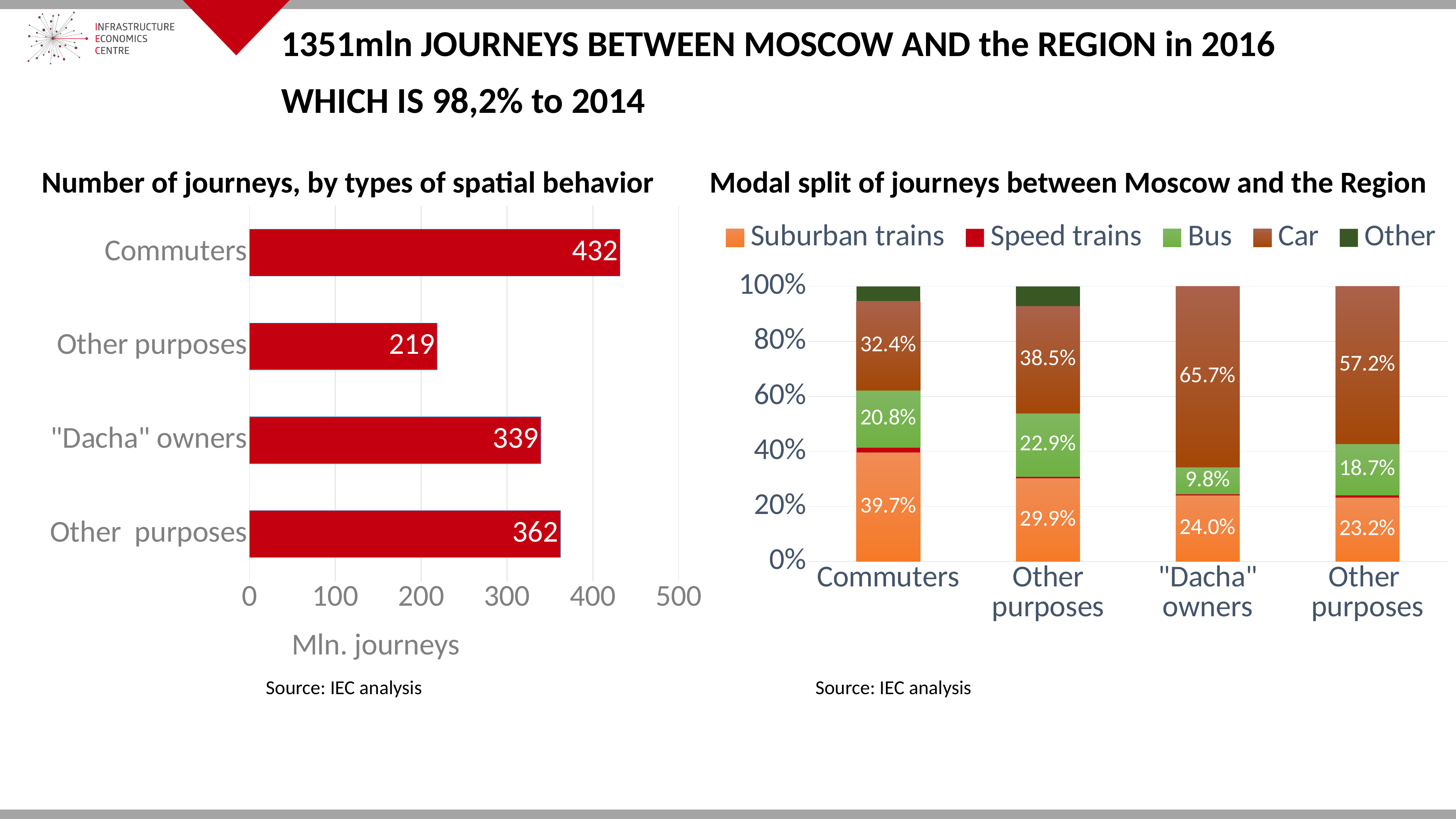
In the chart 'Number of journeys, by types of spatial behavior', which category has the highest value? Commuters How many bars are shown in the chart 'Number of journeys, by types of spatial behavior'? 4 In the chart 'Modal split of journeys between Moscow and the Region', what is the Bus share for "Dacha" owners? 9.8% What kind of chart is 'Number of journeys, by types of spatial behavior'? Bar chart How many series does the legend of the chart 'Modal split of journeys between Moscow and the Region' list? 5 In the chart 'Number of journeys, by types of spatial behavior', what is the difference between the values for Commuters and "Dacha" owners? 93 In the chart 'Number of journeys, by types of spatial behavior', what is the lowest value shown? 219 In the chart 'Modal split of journeys between Moscow and the Region', which has the larger Car share: Commuters or "Dacha" owners? "Dacha" owners In the chart 'Number of journeys, by types of spatial behavior', what is the value for Commuters? 432 In the chart 'Modal split of journeys between Moscow and the Region', what is the Suburban trains share for Commuters? 39.7% In the chart 'Modal split of journeys between Moscow and the Region', what is the Car share for "Dacha" owners? 65.7% In the chart 'Number of journeys, by types of spatial behavior', what is the value for "Dacha" owners? 339